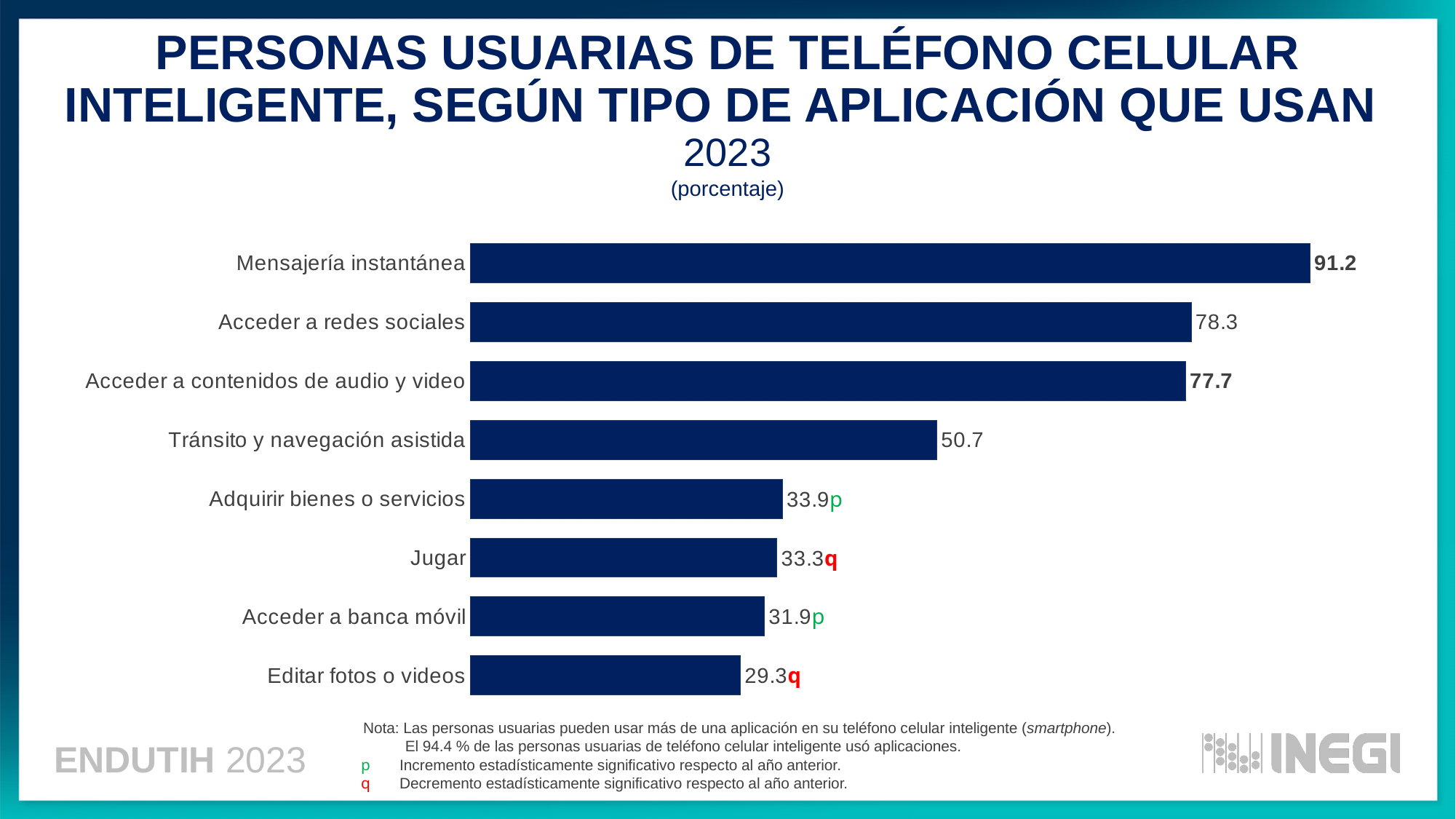
What kind of chart is shown on the slide? Bar chart What is the value for Mensajería instantánea? 91.2 What is the difference between the values for Tránsito y navegación asistida and Editar fotos o videos? 21.4 What is the value for Tránsito y navegación asistida? 50.7 How many categories are shown in the chart? 8 Which category has the lowest value? Editar fotos o videos What is the value for Acceder a banca móvil? 31.9 What is the difference between the values for Mensajería instantánea and Acceder a redes sociales? 12.9 Which is larger, the value for Acceder a redes sociales or the value for Tránsito y navegación asistida? Acceder a redes sociales Which category has the highest value? Mensajería instantánea What year does the chart title refer to? 2023 In what unit are the values expressed, according to the subtitle? porcentaje